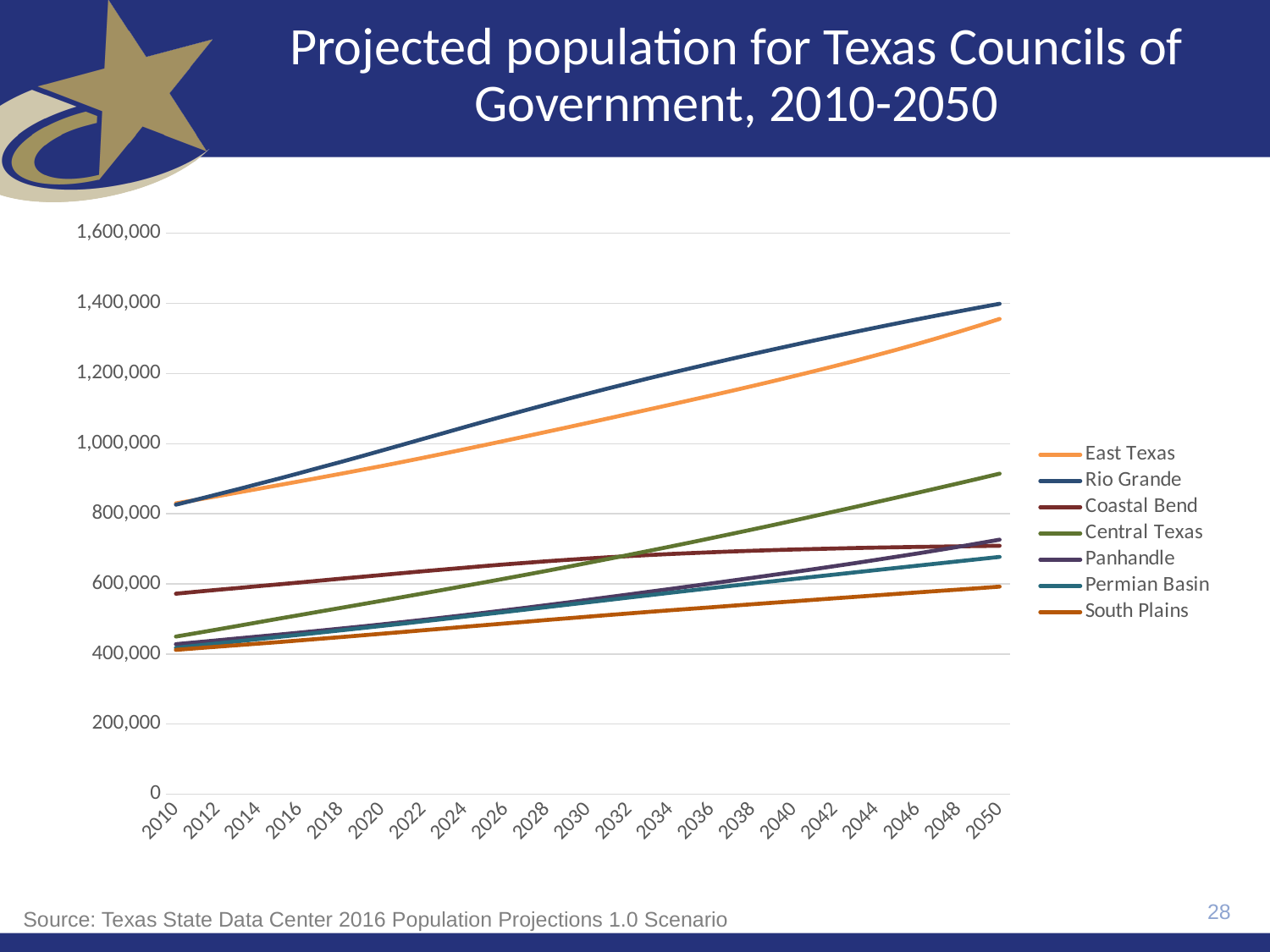
In 2010, which is larger: Coastal Bend or Central Texas? Coastal Bend Which series has the highest projected population in 2050? Rio Grande Is the value for Rio Grande in 2050 greater or less than 1,200,000? greater What kind of chart is shown on the slide? Line chart How many year labels are shown along the x axis? 21 Which series has the lowest projected population in 2050? South Plains Does the East Texas line rise or fall from 2010 to 2050? Rise Is the value for Central Texas in 2050 greater or less than 800,000? greater How many series does the legend list? 7 In 2050, which is larger: Central Texas or Coastal Bend? Central Texas What is the title of the chart on the slide? Projected population for Texas Councils of Government, 2010-2050 Is the value for Coastal Bend in 2010 greater or less than 600,000? less